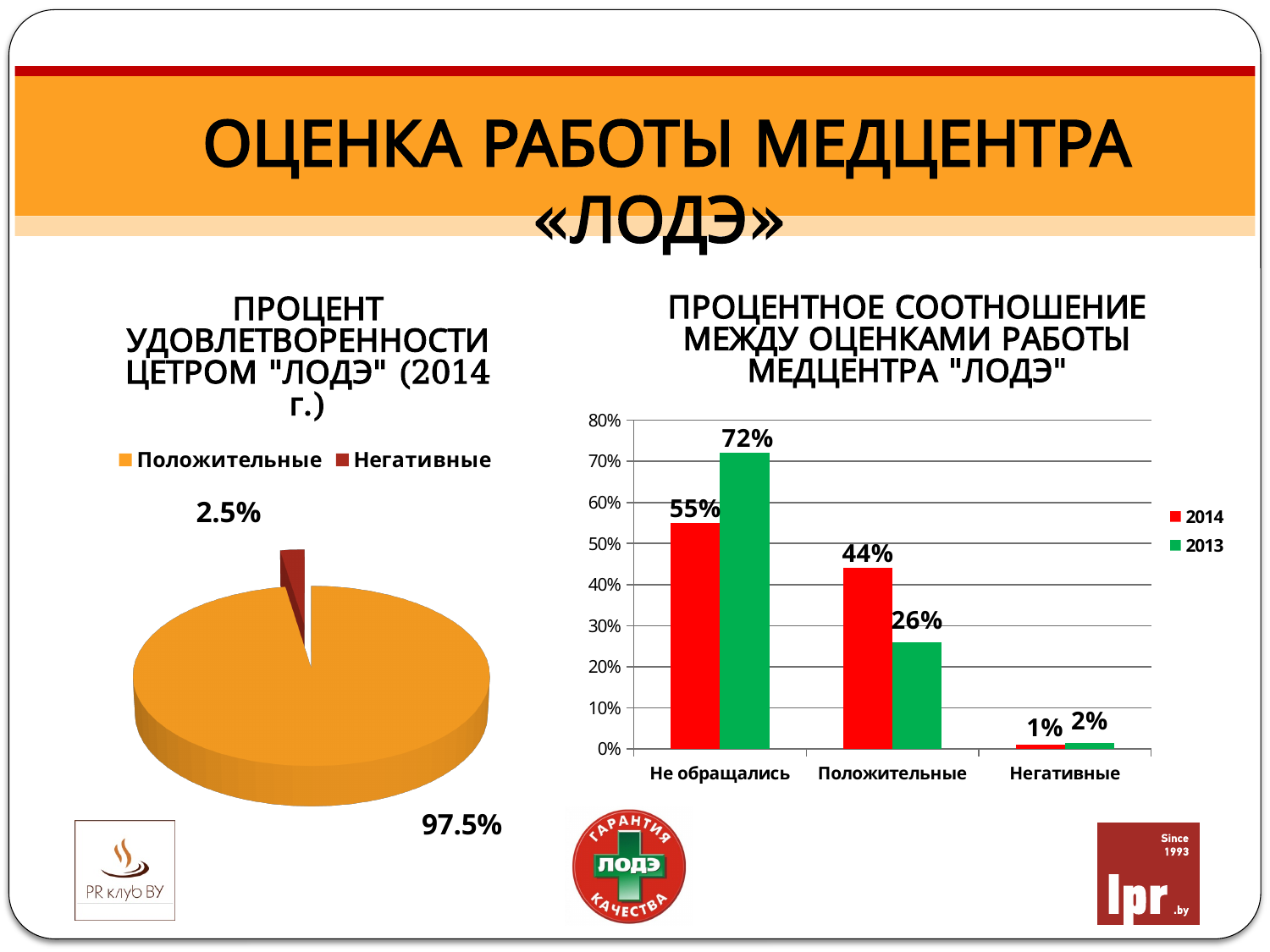
In the bar chart on the right, which is larger for Не обращались: the 2014 value or the 2013 value? 2013 In the bar chart on the right, which category has the lowest 2014 value? Негативные What kind of chart is the chart on the left of the slide? pie chart In the pie chart on the left, what is the value for Негативные? 2.5% In the bar chart on the right, what is the 2014 value for Не обращались? 55% In the bar chart on the right, what is the 2013 value for Негативные? 2% In the pie chart on the left, what is the value for Положительные? 97.5% In the bar chart on the right, what is the 2013 value for Положительные? 26% How many series does the legend of the pie chart on the left list? 2 In the bar chart on the right, what is the difference between the 2014 and 2013 values for Положительные? 18% How many categories are shown on the x axis of the bar chart on the right? 3 In the bar chart on the right, which category has the highest 2013 value? Не обращались